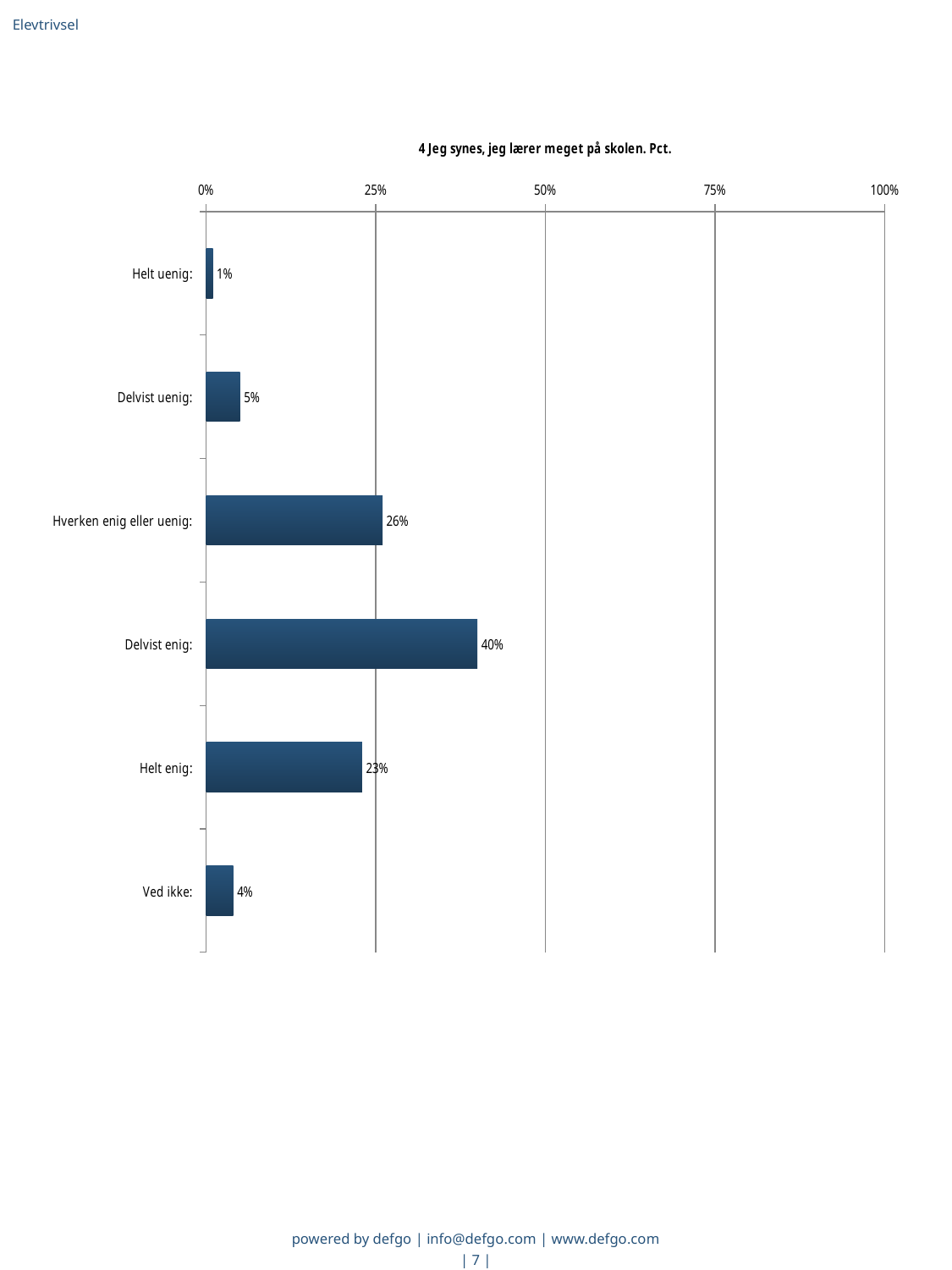
How many categories are shown in the chart? 6 What is the value for Delvist enig? 40% Which category has the lowest value? Helt uenig What is the difference between the values for Delvist enig and Helt enig? 17% What is the value for Hverken enig eller uenig? 26% What is the difference between the values for Delvist uenig and Helt uenig? 4% Is the value for Delvist enig greater or less than 25%? greater What is the value for Ved ikke? 4% What kind of chart is shown on the slide? bar chart What is the title of the chart? 4 Jeg synes, jeg lærer meget på skolen. Pct. Which is larger, the value for Hverken enig eller uenig or the value for Helt enig? Hverken enig eller uenig Which category has the highest value? Delvist enig